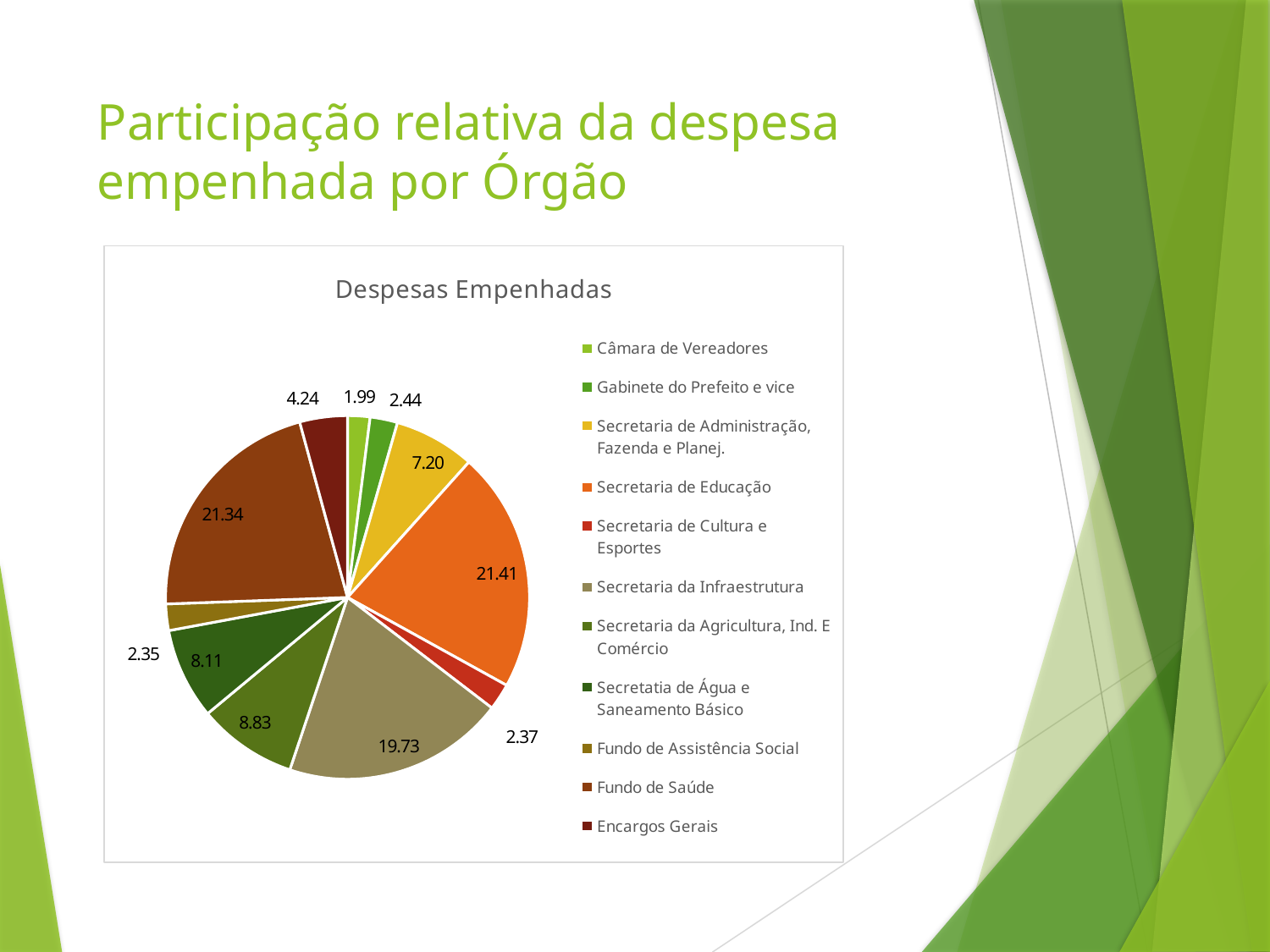
What is the value shown for Fundo de Saúde? 21.34 Which is larger, the value for Secretaria da Agricultura, Ind. E Comércio or the value for Secretatia de Água e Saneamento Básico? Secretaria da Agricultura, Ind. E Comércio What is the value shown for Secretaria da Infraestrutura? 19.73 What kind of chart is shown on the slide? Pie chart What is the value shown for Encargos Gerais? 4.24 What is the value shown for Secretatia de Água e Saneamento Básico? 8.11 What is the title of the chart? Despesas Empenhadas Which category has the smallest slice of the pie? Câmara de Vereadores What is the difference between the values for Secretaria de Educação and Secretaria da Infraestrutura? 1.68 What is the value shown for Secretaria de Educação? 21.41 How many categories does the pie chart show? 11 What is the value shown for Secretaria de Administração, Fazenda e Planej.? 7.20